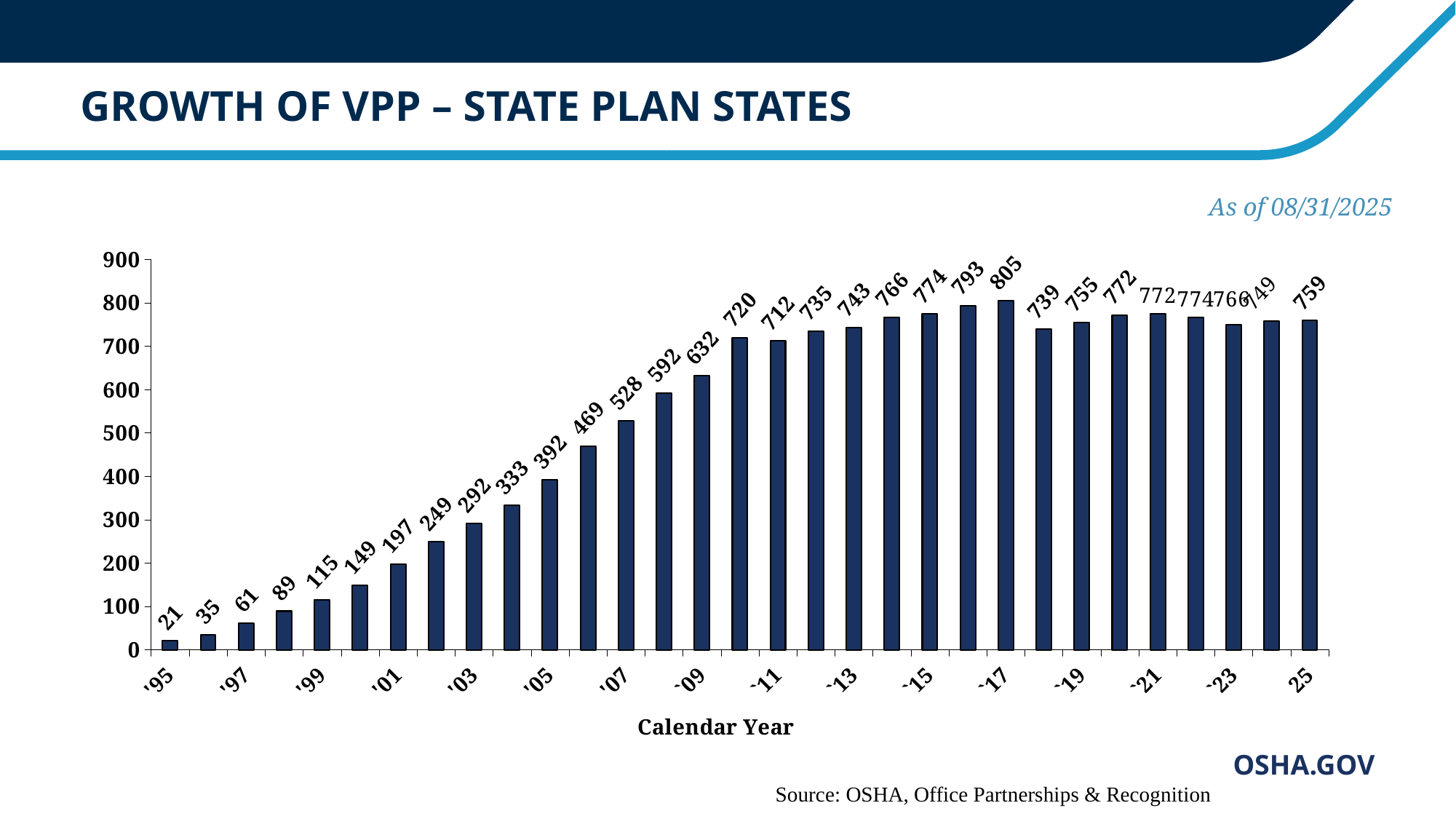
What is the difference between the values for '25 and '95? 738 Which calendar year has the highest number of VPP state plan states? '17 What is the value for '25? 759 What is the title of the x axis? Calendar Year What is the value for '17? 805 Which calendar year has the lowest value on the chart? '95 What is the value for '09? 632 Do the values rise or fall from '95 to '17? rise What kind of chart is shown on the slide? bar chart Which is larger, the value for '19 or the value for '21? '21 What is the value for '01? 197 What is the difference between the values for '17 and '19? 50